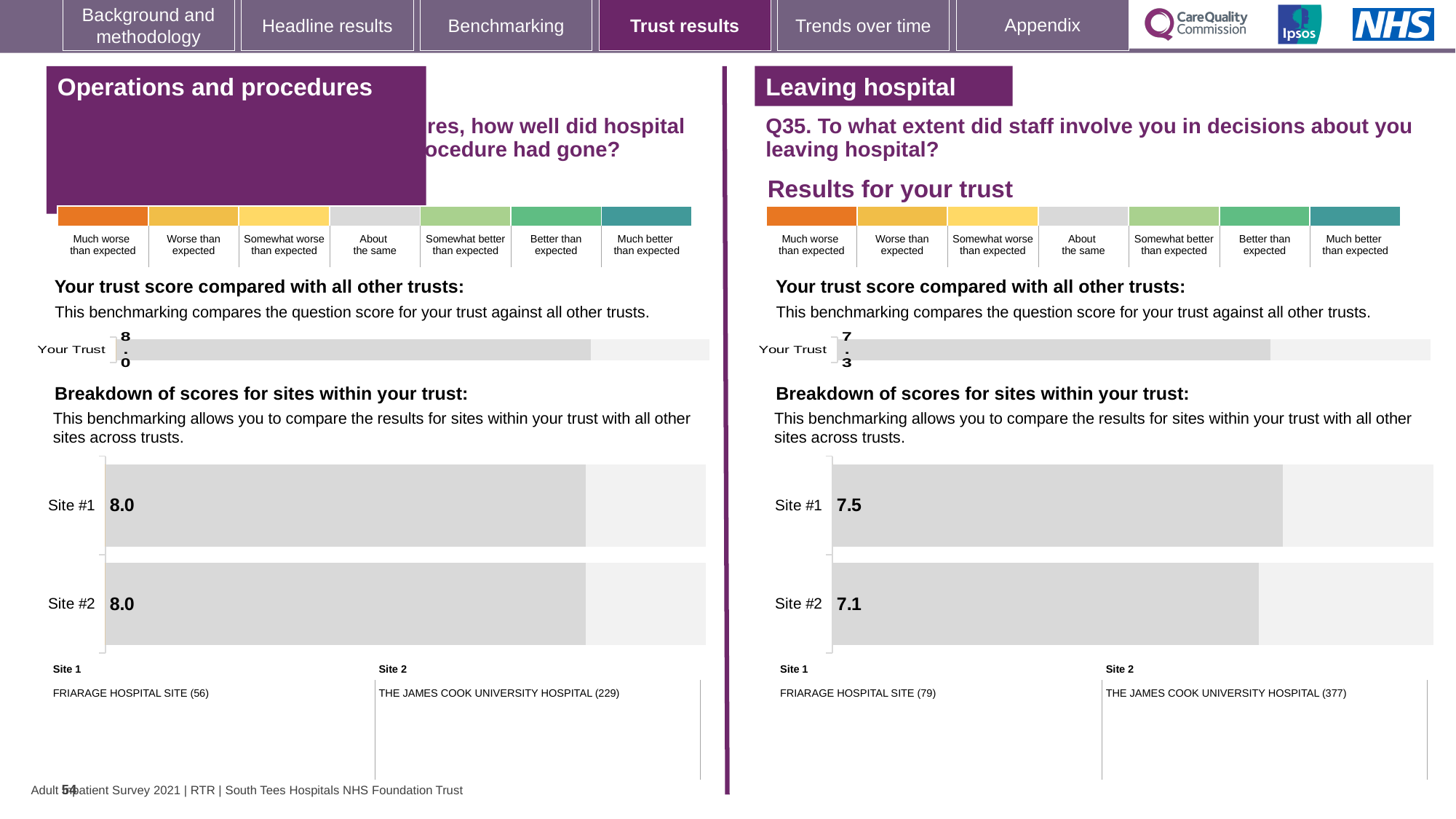
In the 'Leaving hospital' breakdown of scores for sites chart, what is the difference between the Site #1 and Site #2 scores? 0.4 In the 'Leaving hospital' section, which hospital is listed as Site 2? THE JAMES COOK UNIVERSITY HOSPITAL (377) In the 'Operations and procedures' section, what is the 'Your Trust' score in the trust score chart? 8.0 What type of chart is used for the breakdown of scores for sites in the 'Operations and procedures' section? Bar chart In the 'Operations and procedures' section, what is the score shown for Site #2 in the breakdown of scores for sites chart? 8.0 In the 'Leaving hospital' section, what is the score shown for Site #2 in the breakdown of scores for sites chart? 7.1 In the 'Leaving hospital' section, what is the 'Your Trust' score in the trust score chart? 7.3 In the 'Leaving hospital' section, what is the score shown for Site #1 in the breakdown of scores for sites chart? 7.5 In the 'Operations and procedures' section, what is the score shown for Site #1 in the breakdown of scores for sites chart? 8.0 Which is larger: the Site #1 score in the 'Operations and procedures' breakdown chart or the Site #1 score in the 'Leaving hospital' breakdown chart? Operations and procedures (8.0) In the 'Leaving hospital' breakdown of scores for sites chart, which site has the higher score? Site #1 How many sites are shown in the 'Leaving hospital' breakdown of scores for sites chart? 2